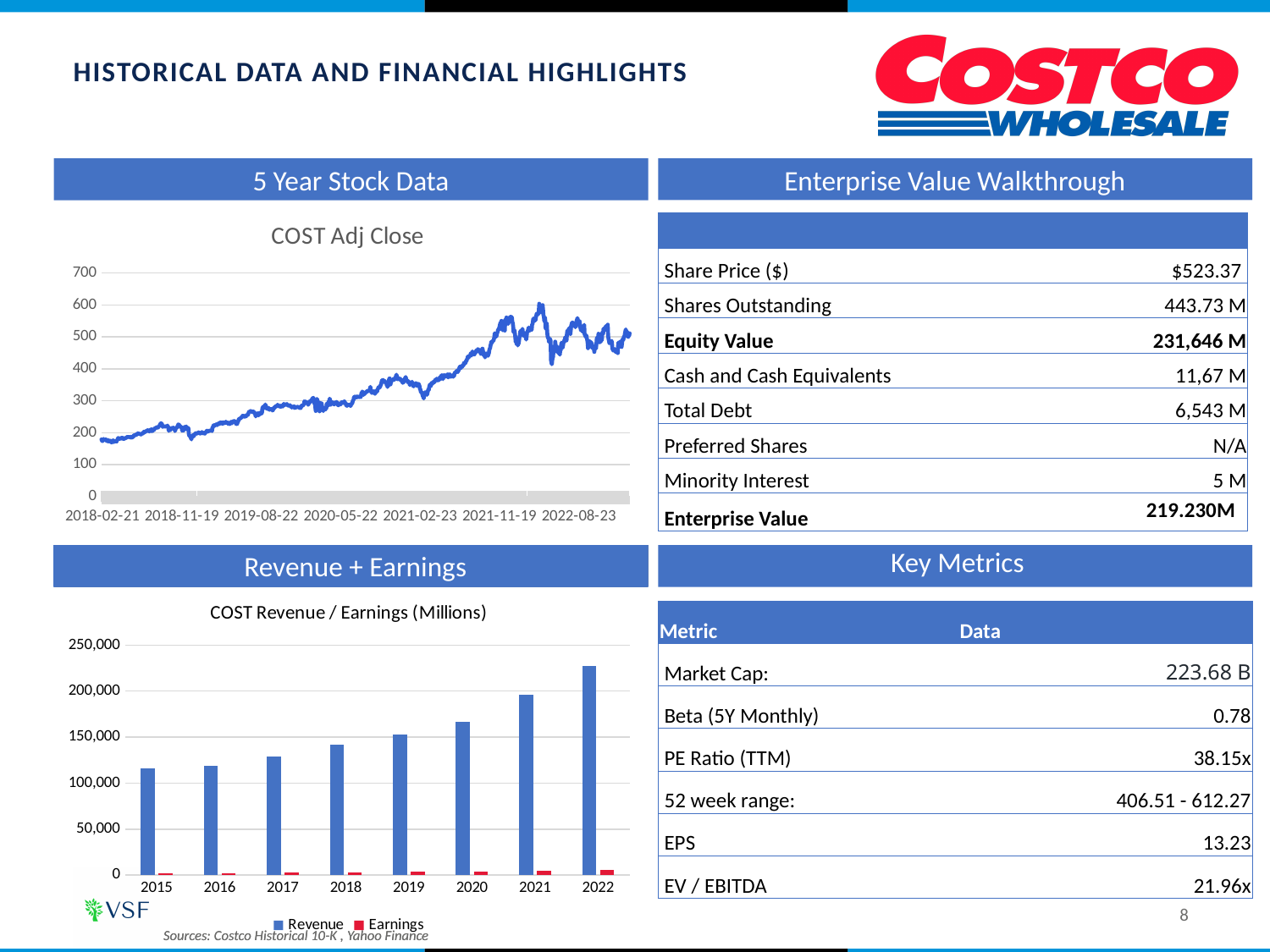
What kind of chart is the COST Revenue / Earnings (Millions) chart? bar chart In the COST Revenue / Earnings (Millions) chart, is the Revenue for 2022 greater or less than 200,000? greater In the COST Revenue / Earnings (Millions) chart, which year has the lowest Revenue? 2015 In the COST Revenue / Earnings (Millions) chart, which year has the highest Revenue? 2022 In the COST Revenue / Earnings (Millions) chart, how many years are shown on the x axis? 8 In the COST Revenue / Earnings (Millions) chart, does Revenue rise or fall from 2015 to 2022? rise In the COST Revenue / Earnings (Millions) chart, how many series does the legend list? 2 In the COST Adj Close chart, does the adjusted close price overall rise or fall from 2018 to 2022? rise In the COST Adj Close chart, is the value at 2018-02-21 greater or less than 300? less In the COST Revenue / Earnings (Millions) chart, which is larger, the Revenue for 2021 or the Revenue for 2019? 2021 In the COST Revenue / Earnings (Millions) chart, is the Revenue for 2015 greater or less than 150,000? less What kind of chart is the COST Adj Close chart? line chart